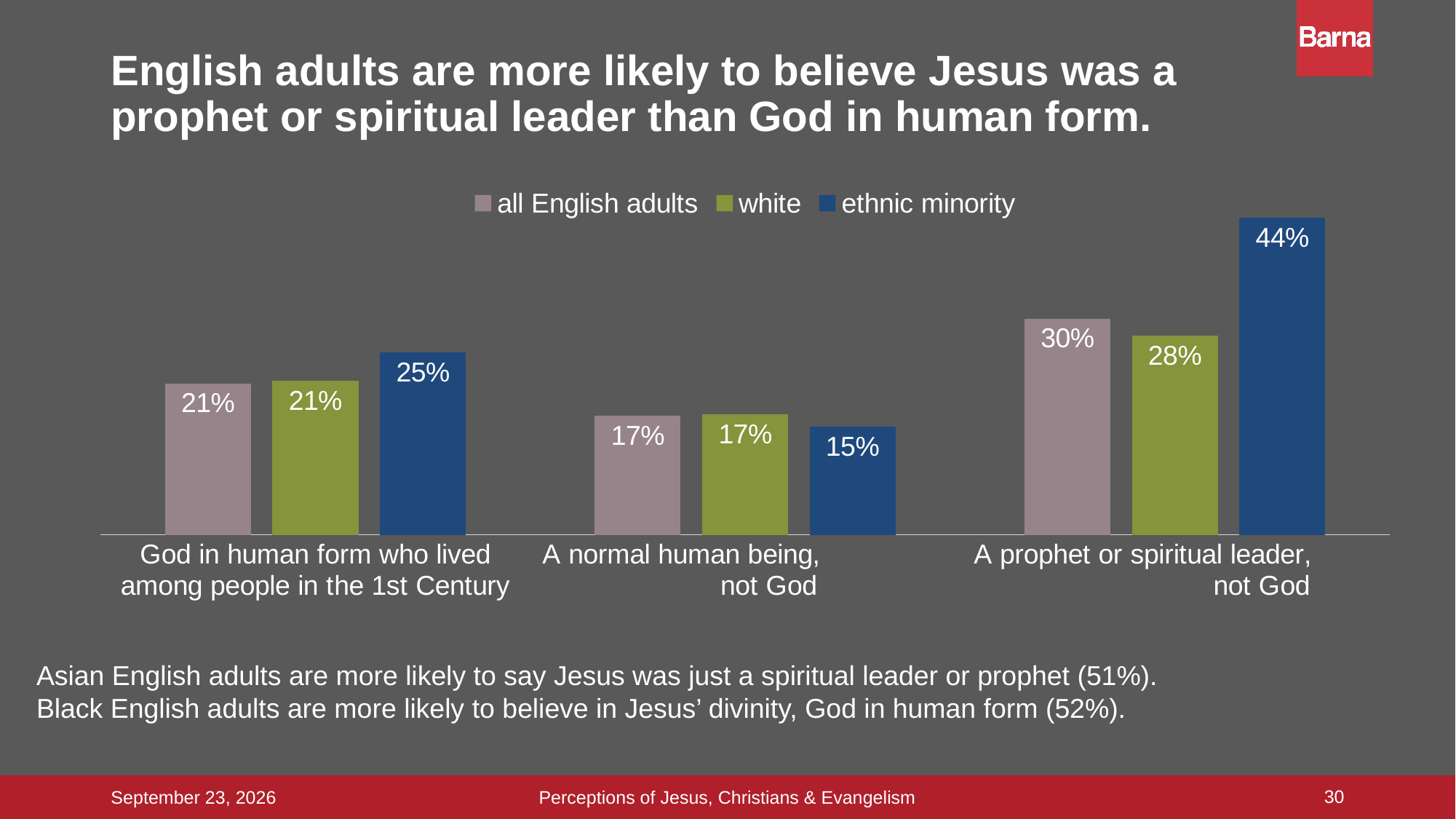
What is the difference between the ethnic minority and all English adults values for 'God in human form who lived among people in the 1st Century'? 4% Which series is shown in blue in the legend? ethnic minority Which category has the lowest value for the ethnic minority series? A normal human being, not God How many series does the legend list? 3 For 'A normal human being, not God', which is larger: the white value or the ethnic minority value? white What kind of chart is shown on the slide? bar chart How many categories are shown on the x axis? 3 What percentage of ethnic minority respondents believe Jesus was a prophet or spiritual leader, not God? 44% What is the difference between the ethnic minority and white values for 'A prophet or spiritual leader, not God'? 16% What is the value for white respondents for 'God in human form who lived among people in the 1st Century'? 21% Which category has the highest value for the ethnic minority series? A prophet or spiritual leader, not God What is the value for all English adults for 'A normal human being, not God'? 17%